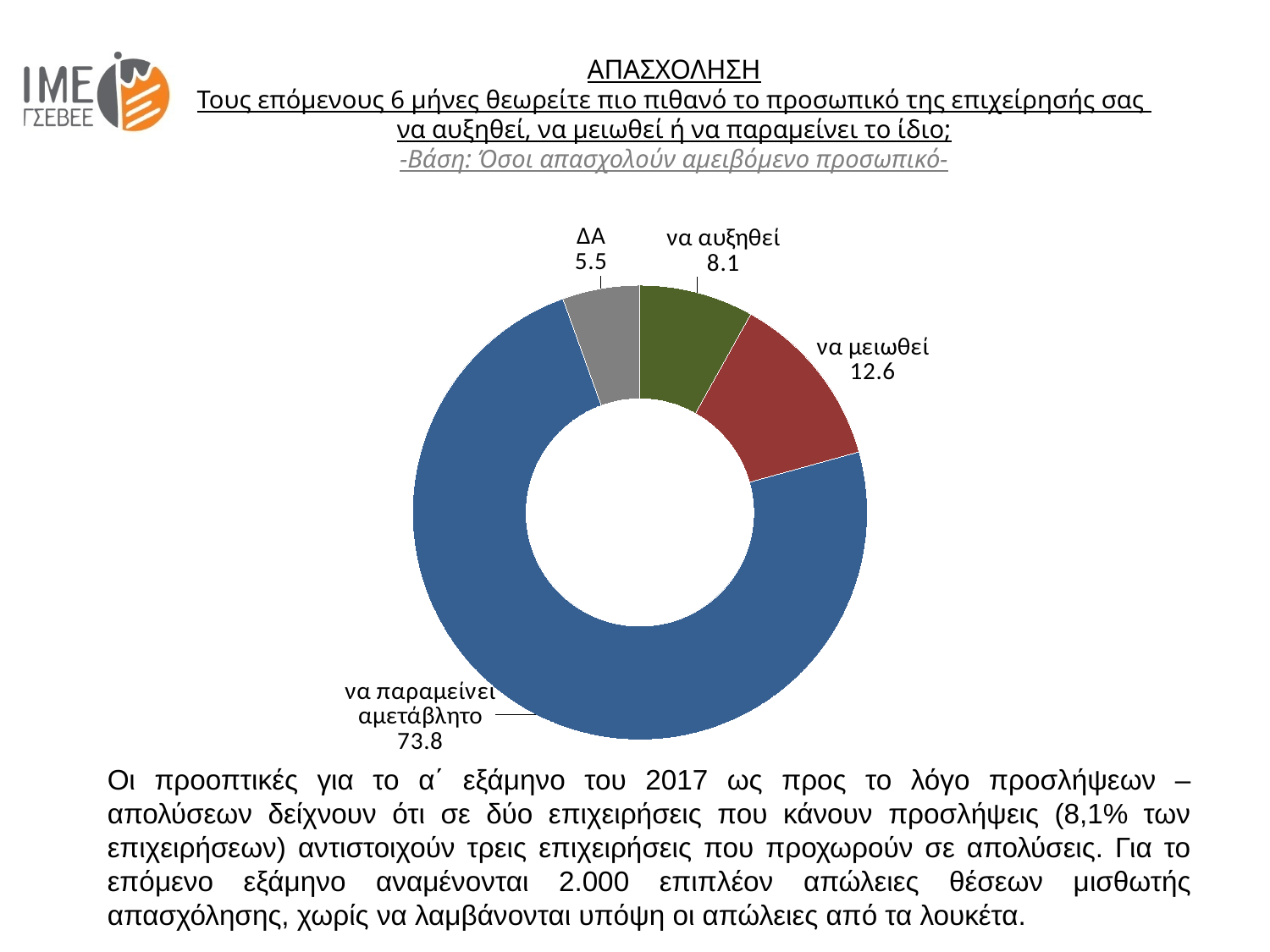
What value is shown for the slice labelled "να παραμείνει αμετάβλητο"? 73.8 What is the difference between the values for "να μειωθεί" and "να αυξηθεί"? 4.5 What kind of chart is shown on the slide? doughnut chart What is the difference between the values for "να παραμείνει αμετάβλητο" and "να μειωθεί"? 61.2 Which slice has the smallest value? ΔΑ What value is shown for the slice labelled "ΔΑ"? 5.5 How many slices does the chart have? 4 Which is larger, the value for "να μειωθεί" or the value for "να αυξηθεί"? να μειωθεί Which slice has the largest value? να παραμείνει αμετάβλητο What value is shown for the slice labelled "να μειωθεί"? 12.6 What value is shown for the slice labelled "να αυξηθεί"? 8.1 What colour is the slice labelled "να μειωθεί"? red